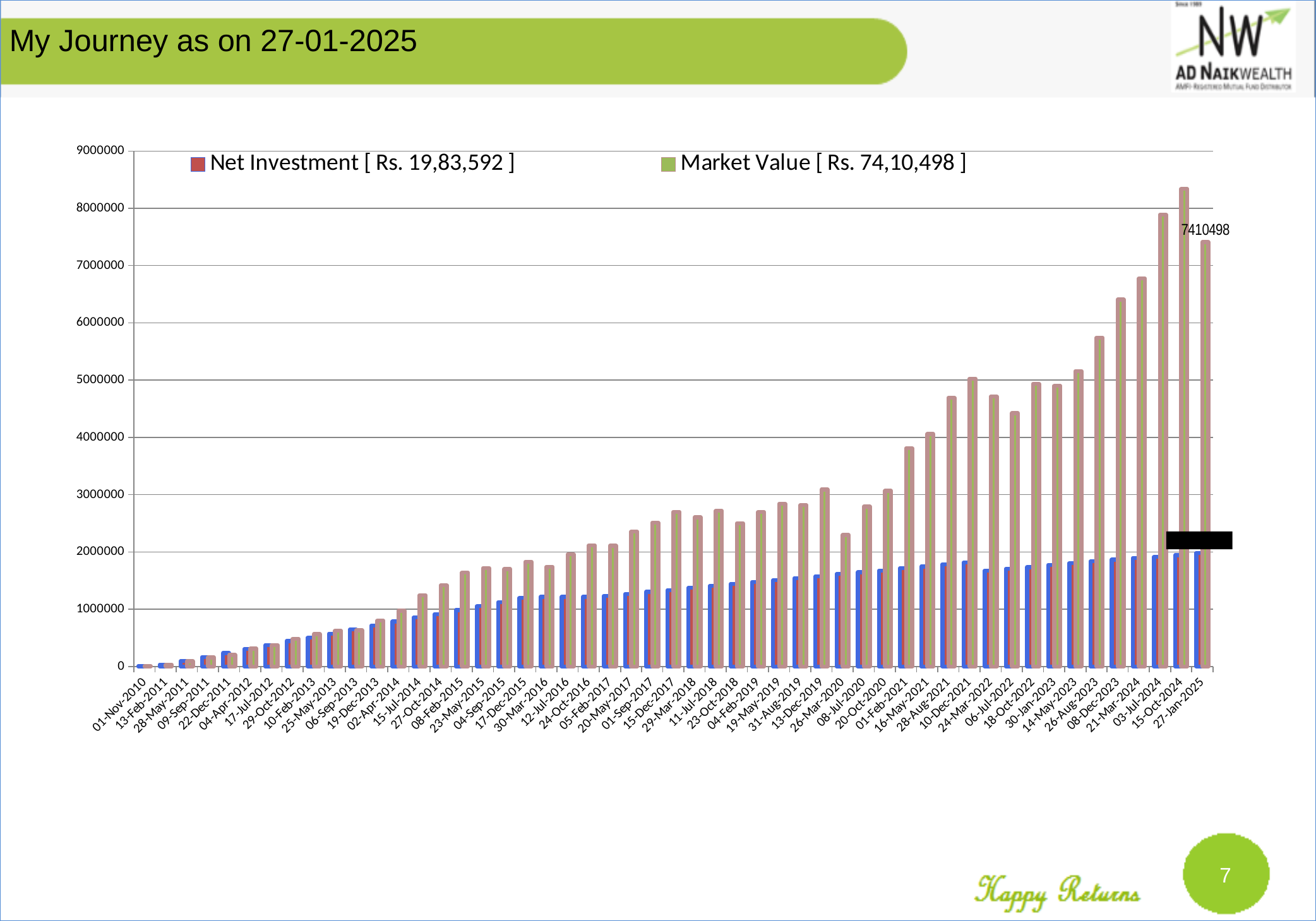
On which date is the Market Value bar the highest? 15-Oct-2024 What Market Value amount is stated in the legend? Rs. 74,10,498 Is the Net Investment for 01-Feb-2021 greater or less than 2000000? less How many series does the chart legend list? 2 What kind of chart is shown on the slide? bar chart For 27-Jan-2025, which is larger: Net Investment or Market Value? Market Value Is the Market Value for 28-Aug-2021 greater or less than 4000000? greater What Net Investment amount is stated in the legend? Rs. 19,83,592 Is the Market Value for 15-Oct-2024 greater or less than 8000000? greater What is the Market Value shown by the data label for 27-Jan-2025? 7410498 Does the Net Investment series generally rise or fall from 01-Nov-2010 to 27-Jan-2025? rise